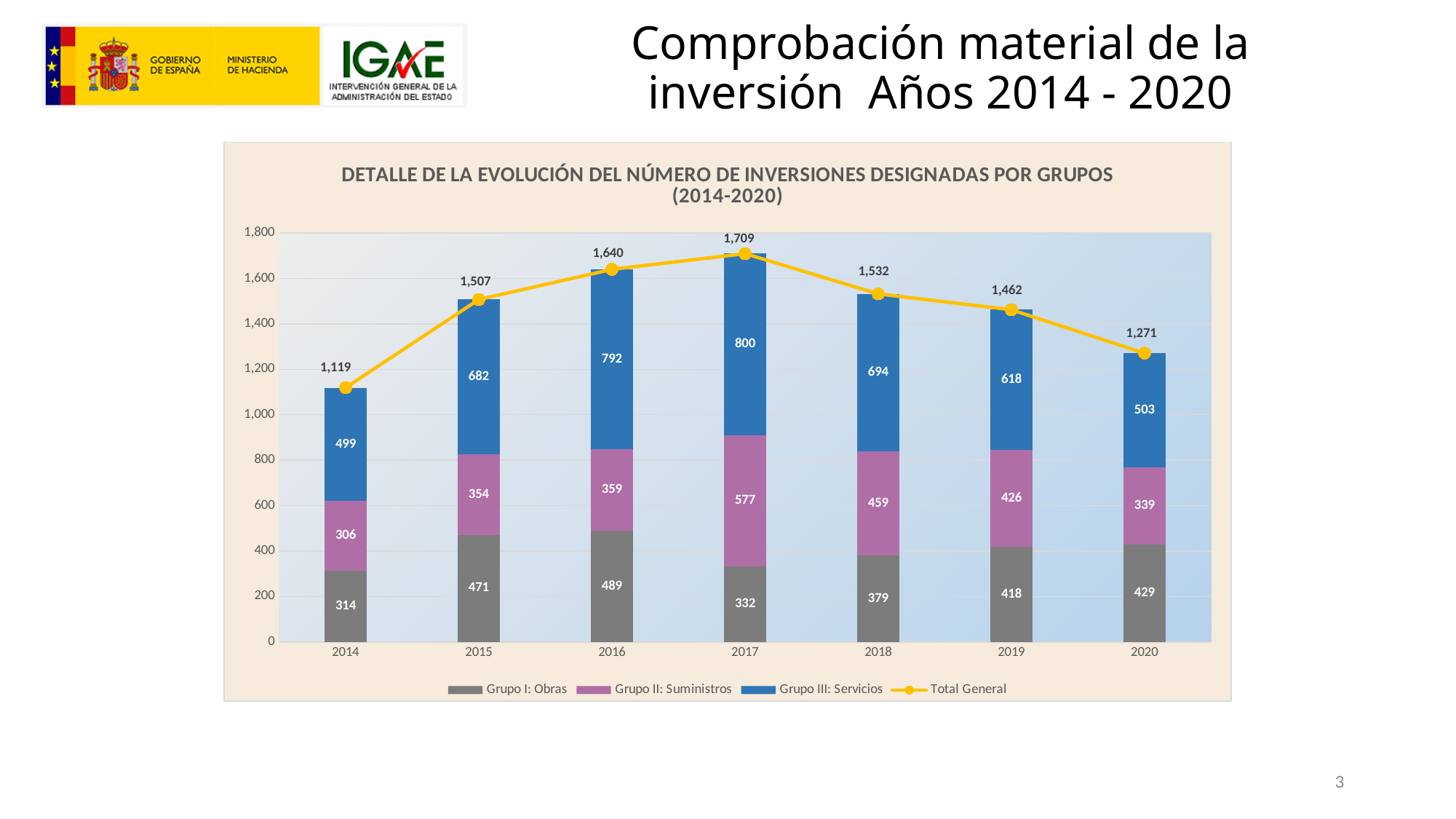
Does the Total General rise or fall from 2017 to 2020? Fall What is the value for Grupo II: Suministros in 2019? 426 How many years are shown on the x axis? 7 Which year has the lowest value for Grupo I: Obras? 2014 Which year has the highest Total General? 2017 What kind of chart is this? Stacked bar chart with a line What is the Total General value for 2014? 1,119 How many series does the legend list? 4 Is the Total General for 2018 greater or less than 1,400? greater Which is larger, Grupo I: Obras in 2016 or Grupo I: Obras in 2020? 2016 What is the value for Grupo III: Servicios in 2017? 800 What is the difference between the Total General for 2017 and 2020? 438